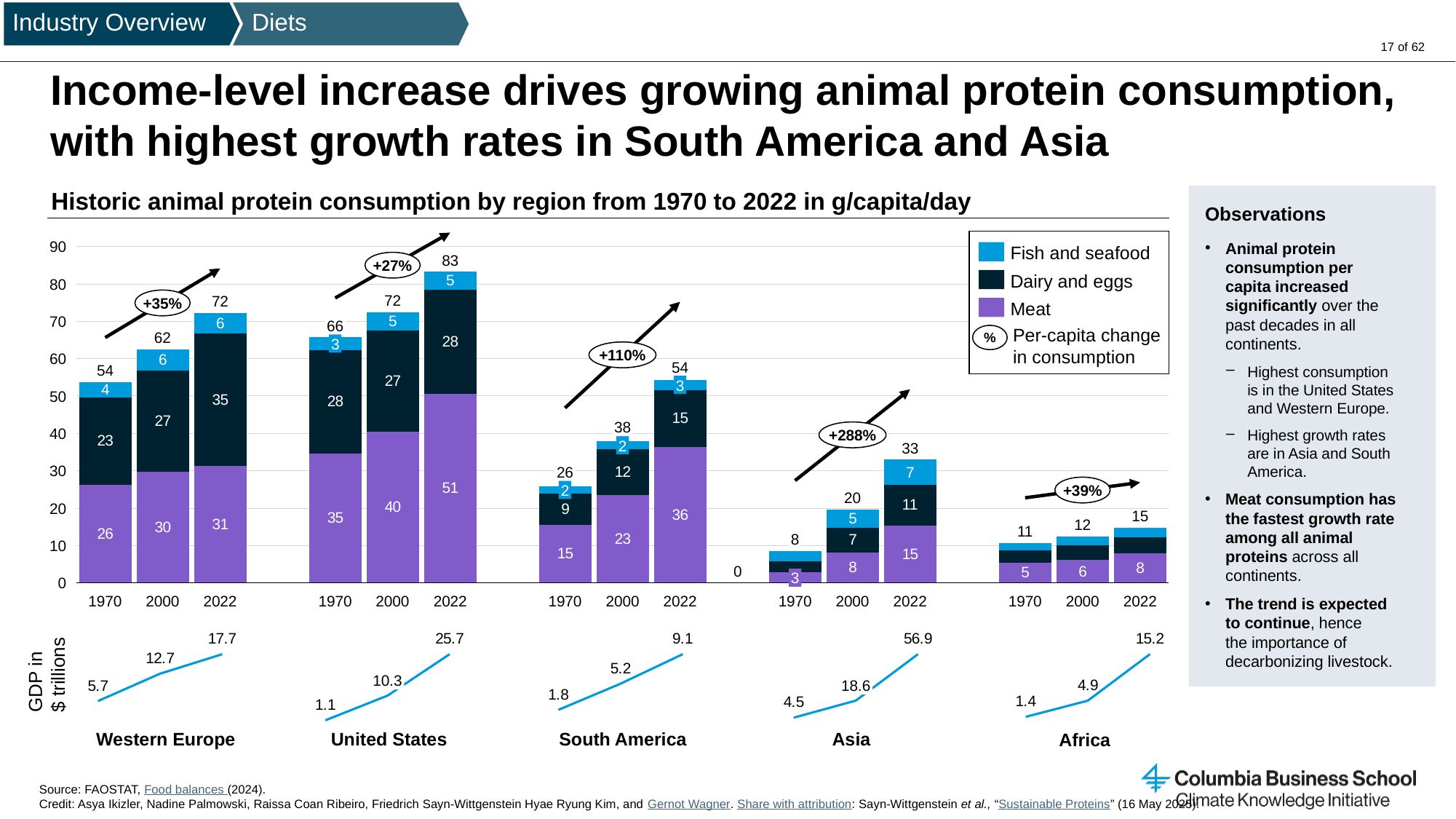
In the stacked bar chart, which region and year has the highest total animal protein consumption? United States, 2022 In the stacked bar chart, what is the Meat value for Western Europe in 1970? 26 In the GDP line charts below the bars, what is the GDP value for Asia in 2022? 56.9 How many series does the legend of the stacked bar chart list? 3 How many regions are shown in the stacked bar chart? 5 What kind of chart is used to show animal protein consumption by region? Stacked bar chart In the stacked bar chart, what is the total animal protein consumption for the United States in 2022? 83 In the stacked bar chart, which is larger: the 2022 total for South America or the 2022 total for Asia? South America In the stacked bar chart, do the total values for Asia rise or fall from 1970 to 2022? Rise In the stacked bar chart, what is the Dairy and eggs value for the United States in 2000? 27 In the stacked bar chart, what is the difference between Western Europe's total in 2022 and its total in 1970? 18 What per-capita change in consumption is shown for Asia? +288%